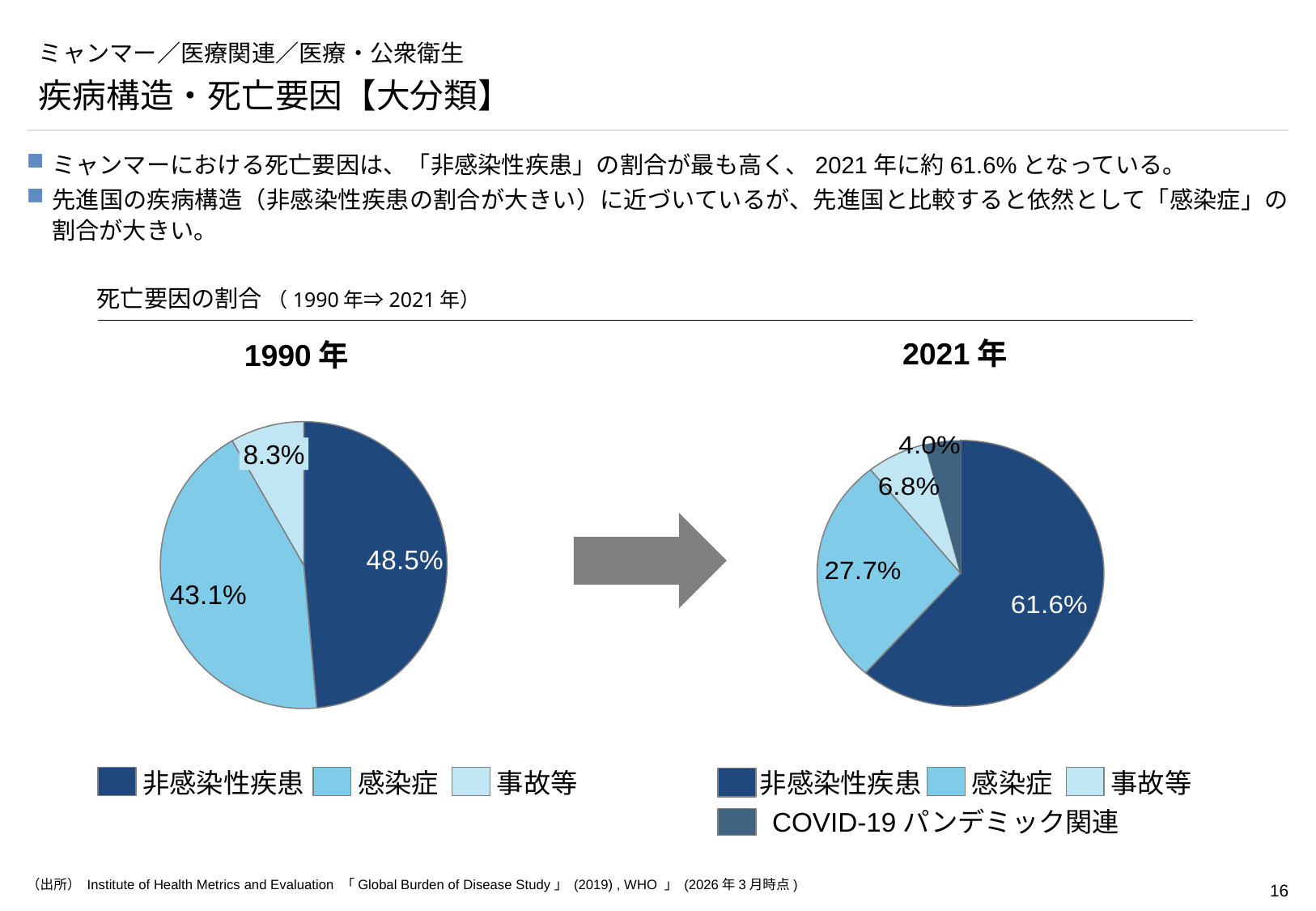
In the 1990年 pie chart, what share is shown for 非感染性疾患? 48.5% In the 1990年 pie chart, which category has the smallest share? 事故等 Which is larger in the 1990年 pie chart: the share of 非感染性疾患 or the share of 感染症? 非感染性疾患 What kind of chart is used to show the 1990年 and 2021年 data? Pie chart In the 2021年 pie chart, what share is shown for COVID-19 パンデミック関連? 4.0% In the 2021年 pie chart, which category has the largest share? 非感染性疾患 In the 2021年 pie chart, what is the difference between the shares of 非感染性疾患 and 感染症? 33.9% In the 2021年 pie chart, which category has the smallest share? COVID-19 パンデミック関連 How many slices does the 2021年 pie chart have? 4 In the 2021年 pie chart, what share is shown for 非感染性疾患? 61.6% How many entries does the legend of the 1990年 chart list? 3 In the 1990年 pie chart, what share is shown for 感染症? 43.1%